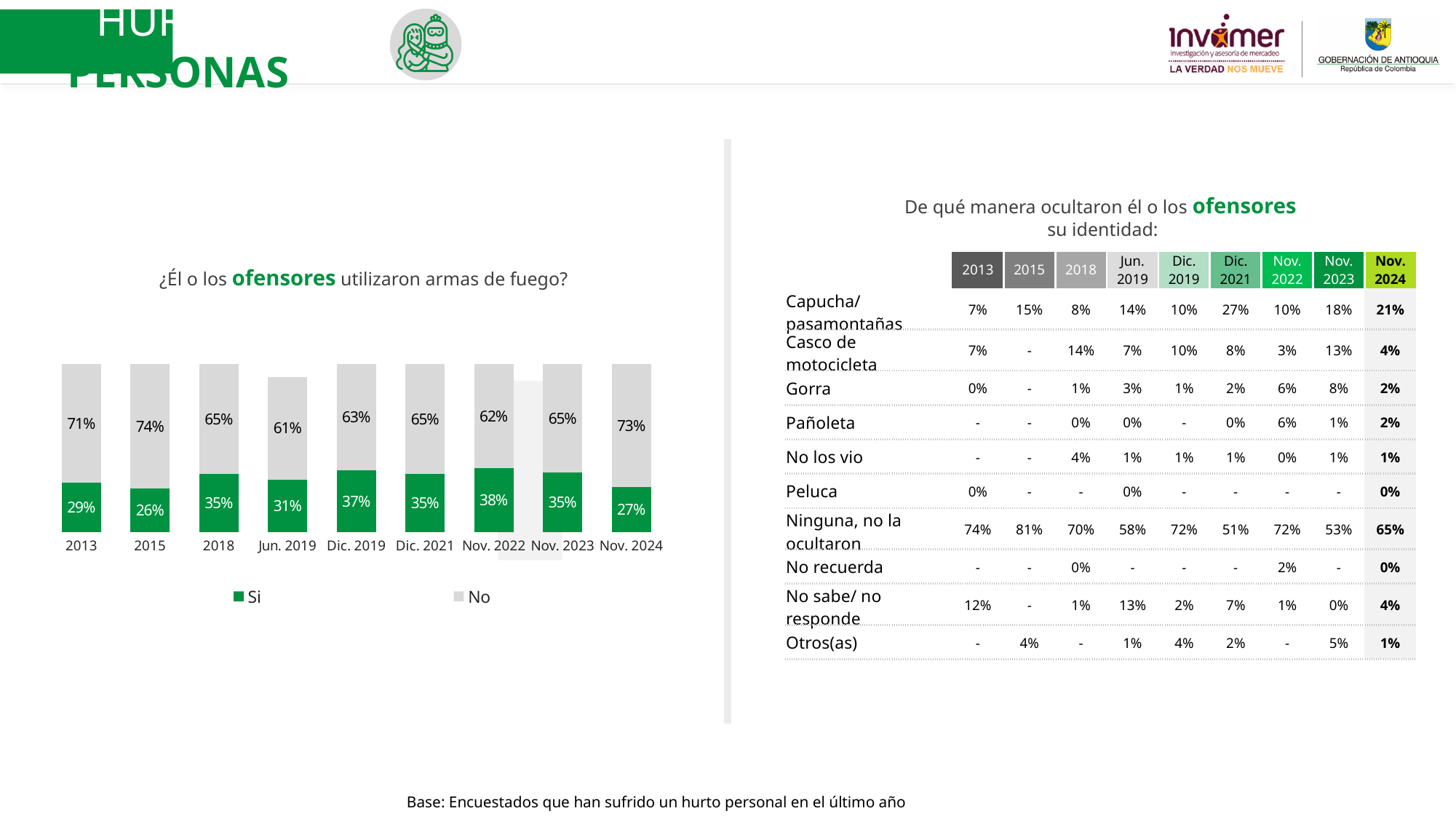
In which period was the 'Si' share highest in the firearms chart? Nov. 2022 What is the 'Si' value for Dic. 2021 in the firearms chart? 35% What percentage of respondents answered 'Si' in Nov. 2024 in the chart about whether the offenders used firearms? 27% What is the difference between the 'No' value in 2015 and the 'No' value in Jun. 2019 in the firearms chart? 13% How many series does the legend of the firearms chart list? 2 Which colour represents 'Si' in the firearms chart? Green Which is larger in the firearms chart: the 'Si' value for Dic. 2019 or for Nov. 2024? Dic. 2019 What is the total of the 'Si' and 'No' values for Jun. 2019 in the firearms chart? 92% In which period was the 'Si' share lowest in the firearms chart? 2015 What is the 'No' value for 2015 in the firearms chart? 74% How many time periods are shown on the x axis of the firearms chart? 9 What type of chart is used to show whether the offenders used firearms? Stacked bar chart